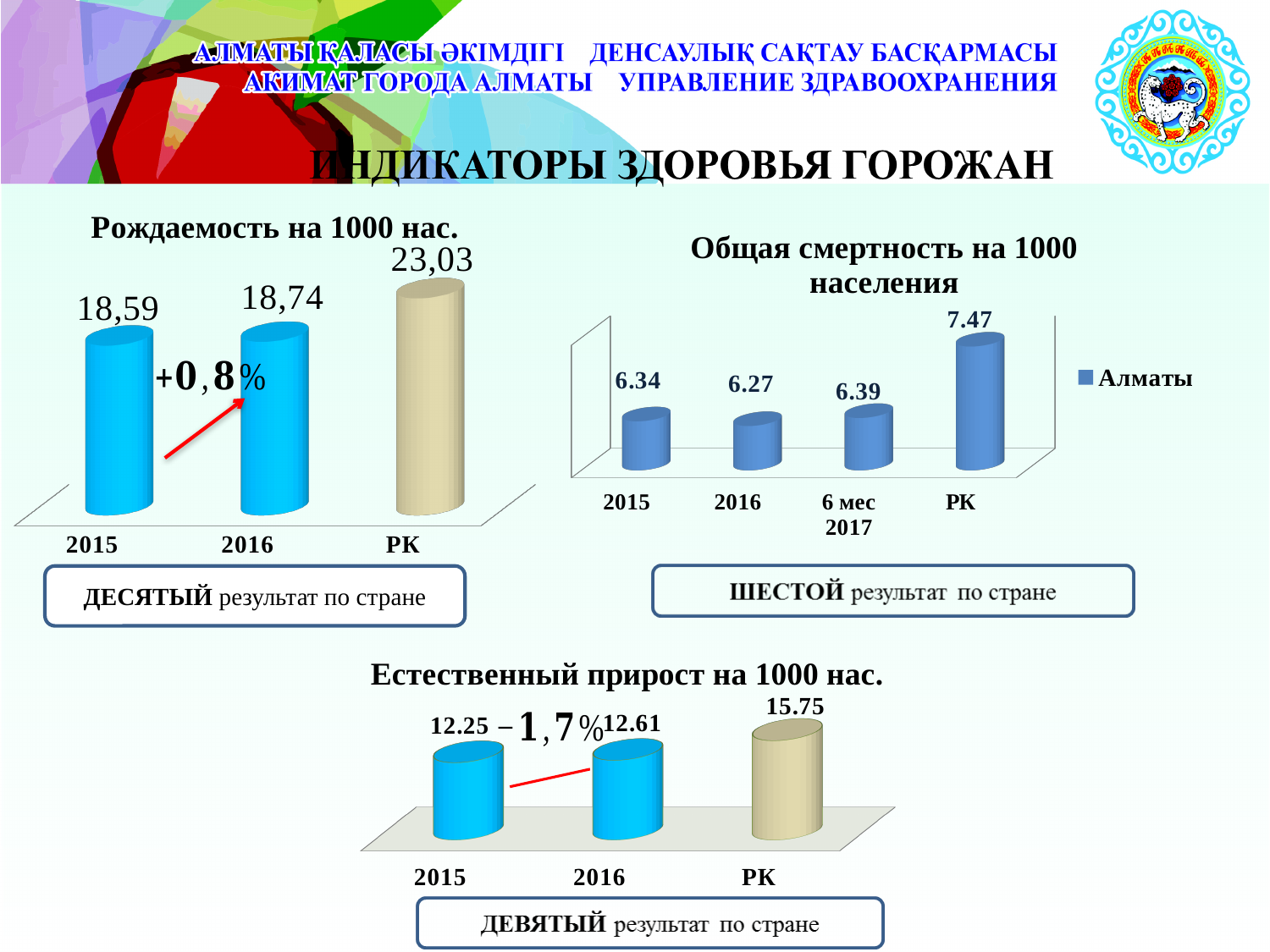
In the chart titled "Рождаемость на 1000 нас.", how many bars are plotted? 3 In the chart titled "Общая смертность на 1000 населения", what is the value for 2016? 6.27 In the chart titled "Общая смертность на 1000 населения", which category has the highest value? РК In the chart titled "Общая смертность на 1000 населения", what series name does the legend show? Алматы In the chart titled "Общая смертность на 1000 населения", what is the difference between the РК value and the 2015 value? 1.13 In the chart titled "Рождаемость на 1000 нас.", what is the value for РК? 23,03 In the chart titled "Рождаемость на 1000 нас.", what is the value for 2016? 18,74 In the chart titled "Естественный прирост на 1000 нас.", what is the value for 2015? 12.25 In the chart titled "Рождаемость на 1000 нас.", which category has the lowest value? 2015 What type of chart is the chart titled "Естественный прирост на 1000 нас."? Bar chart In the chart titled "Естественный прирост на 1000 нас.", which is larger, the value for 2016 or the value for РК? РК In the chart titled "Общая смертность на 1000 населения", what is the value for 6 мес 2017? 6.39